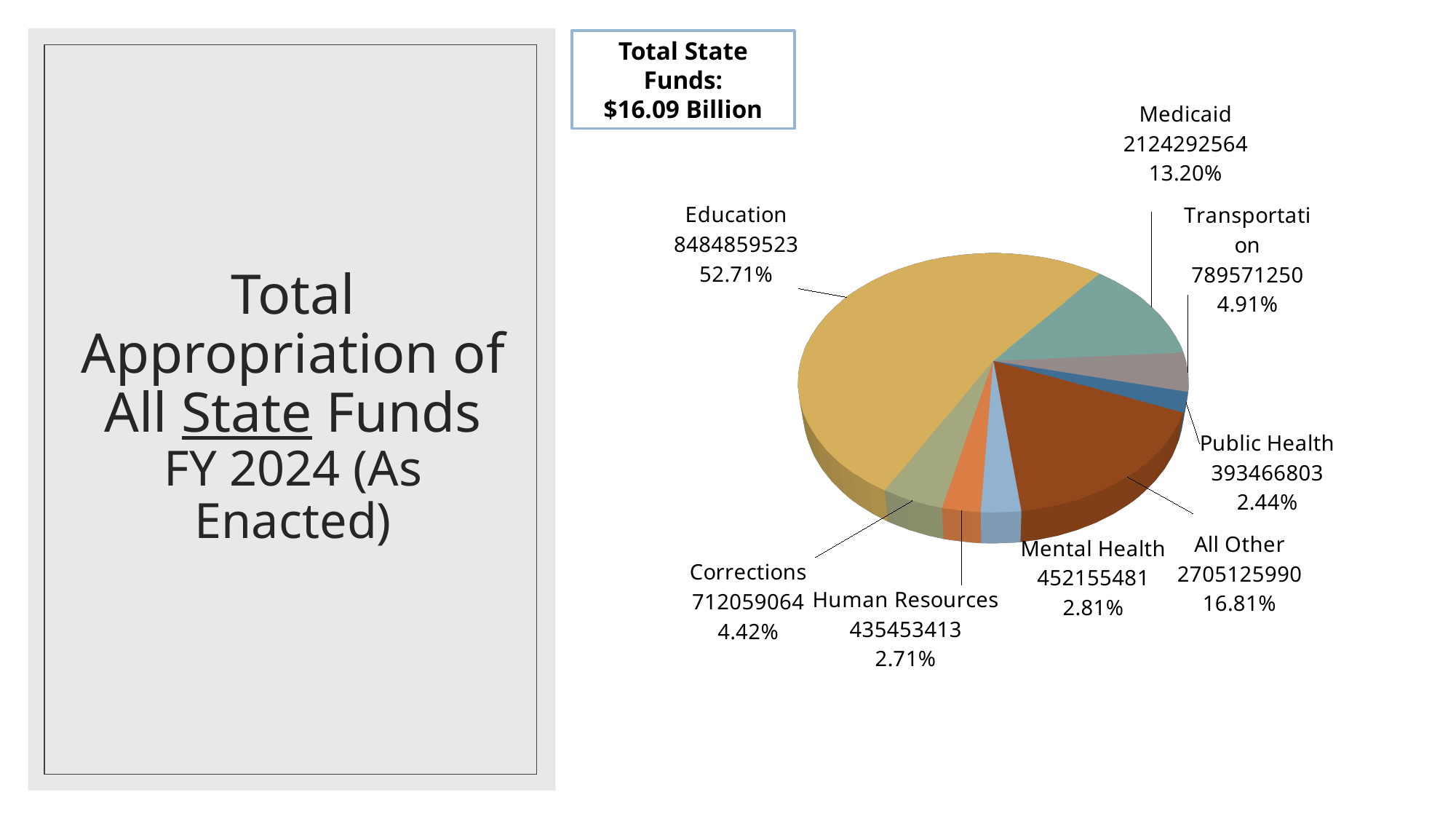
What percentage share does Public Health have? 2.44% What is the value shown for Corrections? 712059064 What is the value shown for Education? 8484859523 What total state funds amount is shown in the box above the chart? $16.09 Billion Which category has the largest slice? Education Which is larger, Transportation or Corrections? Transportation What is the difference between the values for Mental Health and Human Resources? 16702068 How many slices does the pie chart have? 8 What percentage share does All Other have? 16.81% Which category has the smallest slice? Public Health What percentage share does Medicaid have? 13.20% What kind of chart is shown on the slide? Pie chart